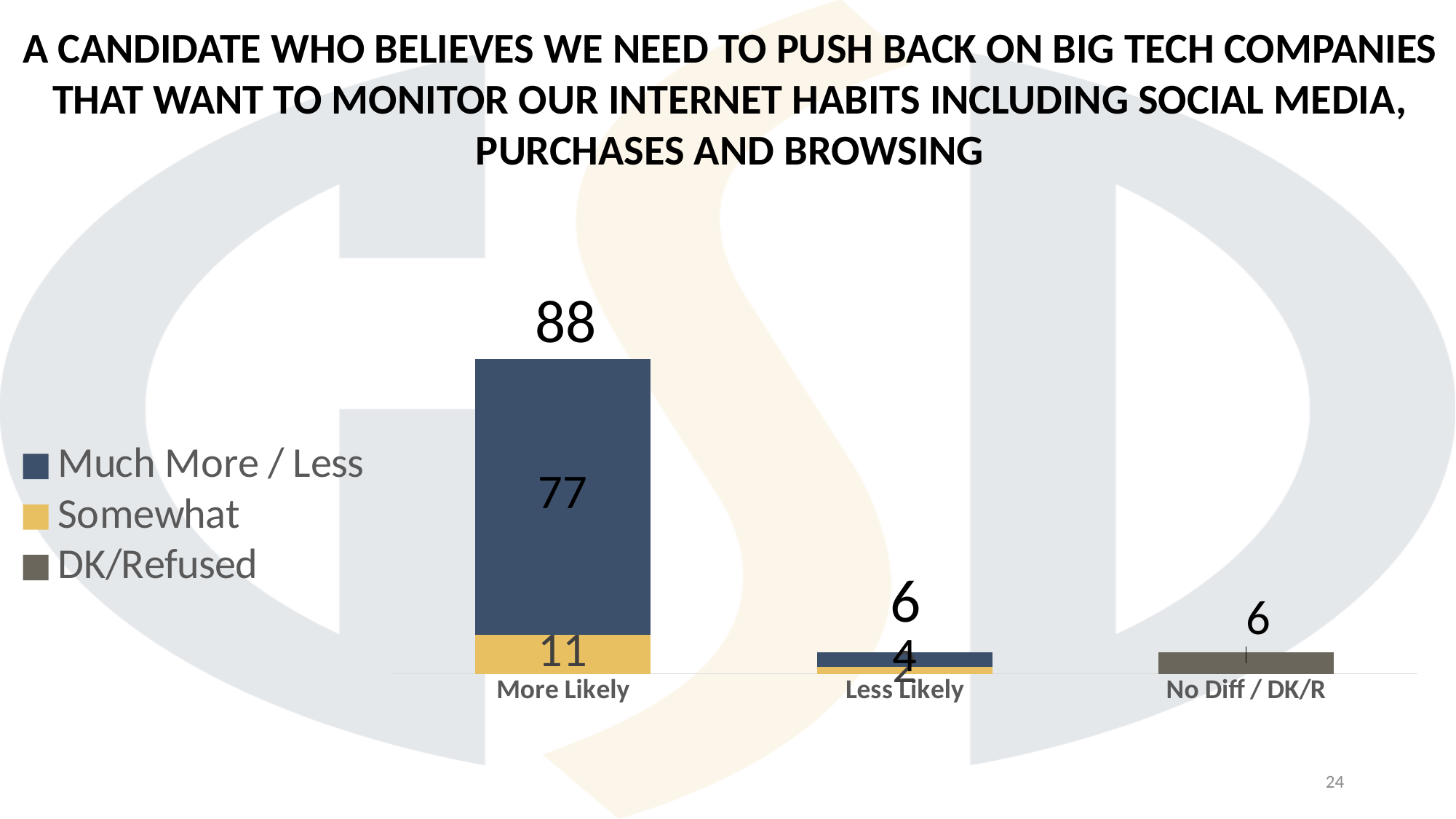
Which is larger, the More Likely total or the No Diff / DK/R value? More Likely total Which category has the highest total value? More Likely What is the total value shown above the More Likely bar? 88 What is the value for the No Diff / DK/R category? 6 How many categories are shown on the x axis? 3 What is the Somewhat value for the More Likely category? 11 What is the total value shown above the Less Likely bar? 6 What is the difference between the Much More / Less value and the Somewhat value in the More Likely category? 66 How many series does the legend list? 3 What is the difference between the More Likely total and the Less Likely total? 82 What is the Much More / Less value for the More Likely category? 77 What is the Much More / Less value for the Less Likely category? 4